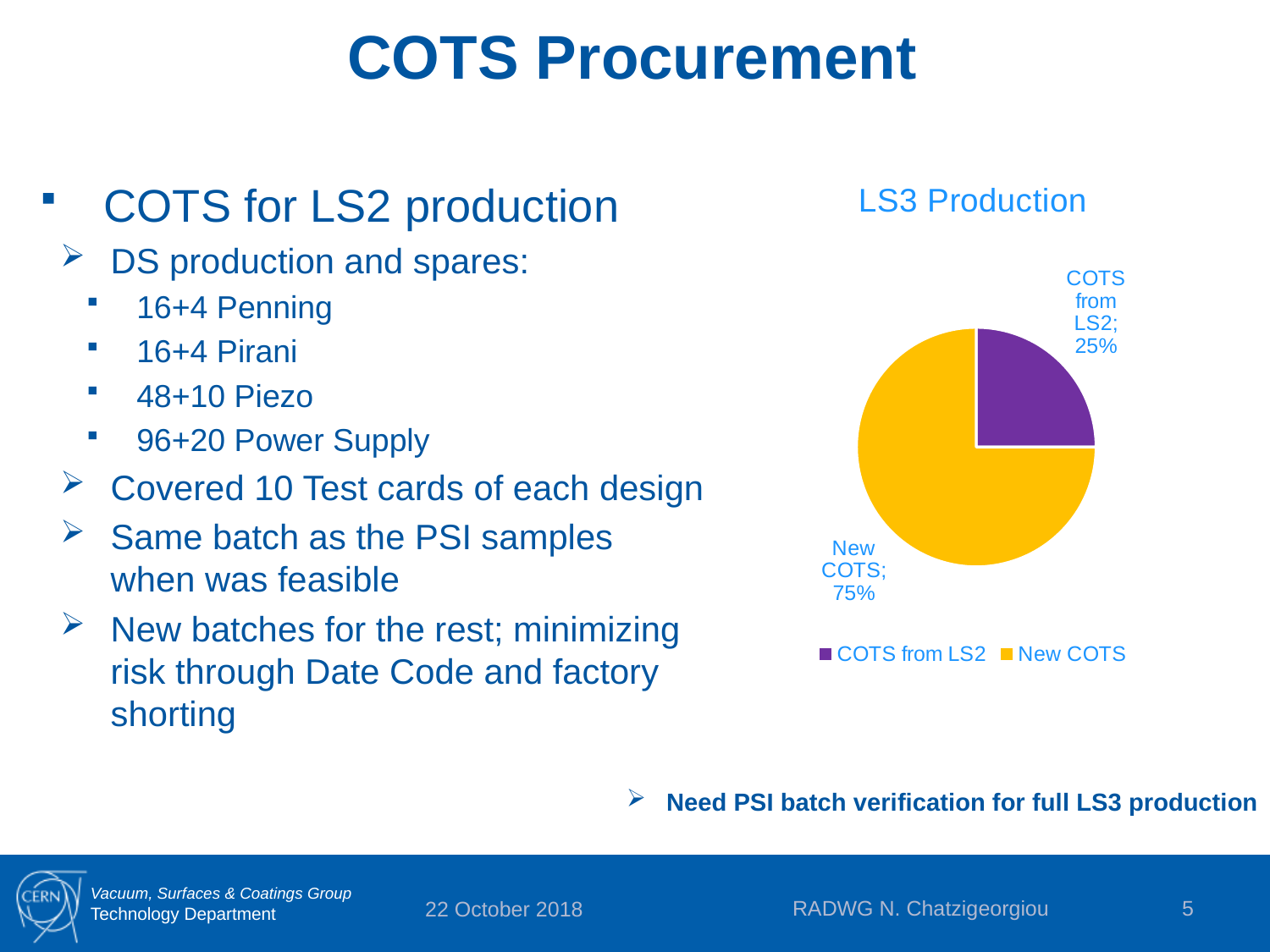
How many slices does the LS3 Production pie chart have? 2 In the LS3 Production pie, which is larger: COTS from LS2 or New COTS? New COTS Which slice of the LS3 Production pie is the largest? New COTS How many entries does the legend of the LS3 Production chart list? 2 What share of the LS3 Production pie is labelled COTS from LS2? 25% What is the title of the chart on the slide? LS3 Production What share of the LS3 Production pie is labelled New COTS? 75% What is the difference in percentage points between the New COTS and COTS from LS2 slices in the LS3 Production pie? 50 What colour is the New COTS slice in the LS3 Production pie? Yellow Which slice of the LS3 Production pie is the smallest? COTS from LS2 What type of chart is shown on the slide? Pie chart